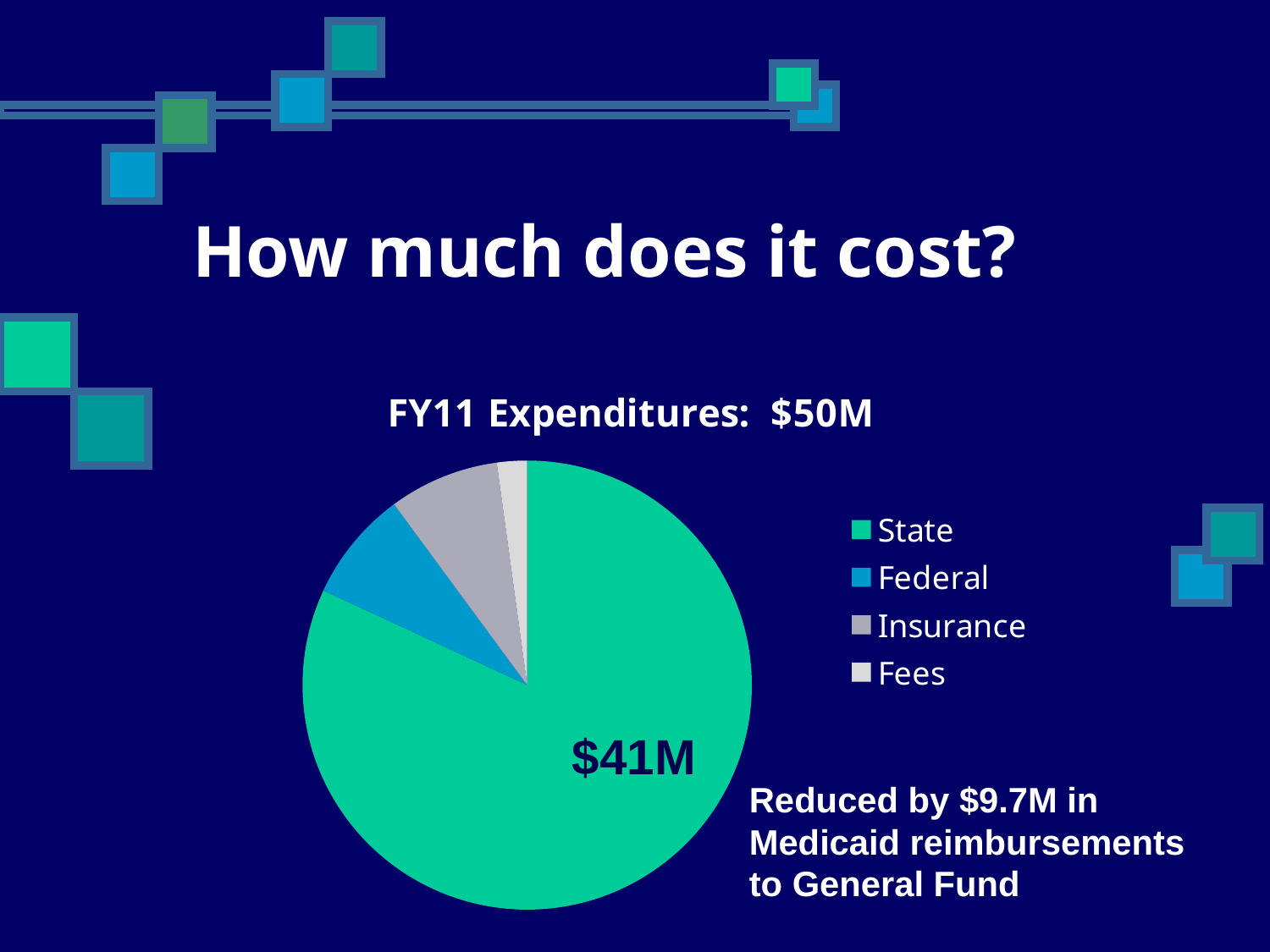
What is the total FY11 expenditure shown in the chart title? $50M What is the title of the chart? FY11 Expenditures: $50M Which is larger, the Federal slice or the Fees slice? Federal What is the value shown for the State slice? $41M Which category has the smallest slice of the pie? Fees What colour is the State slice in the pie chart? green How many slices does the pie chart have? 4 Which is larger, the State slice or the Federal slice? State What share of the $50M total does the State slice ($41M) represent? 82% How many entries does the legend list? 4 What kind of chart is shown on the slide? pie chart Which category has the largest slice of the pie? State